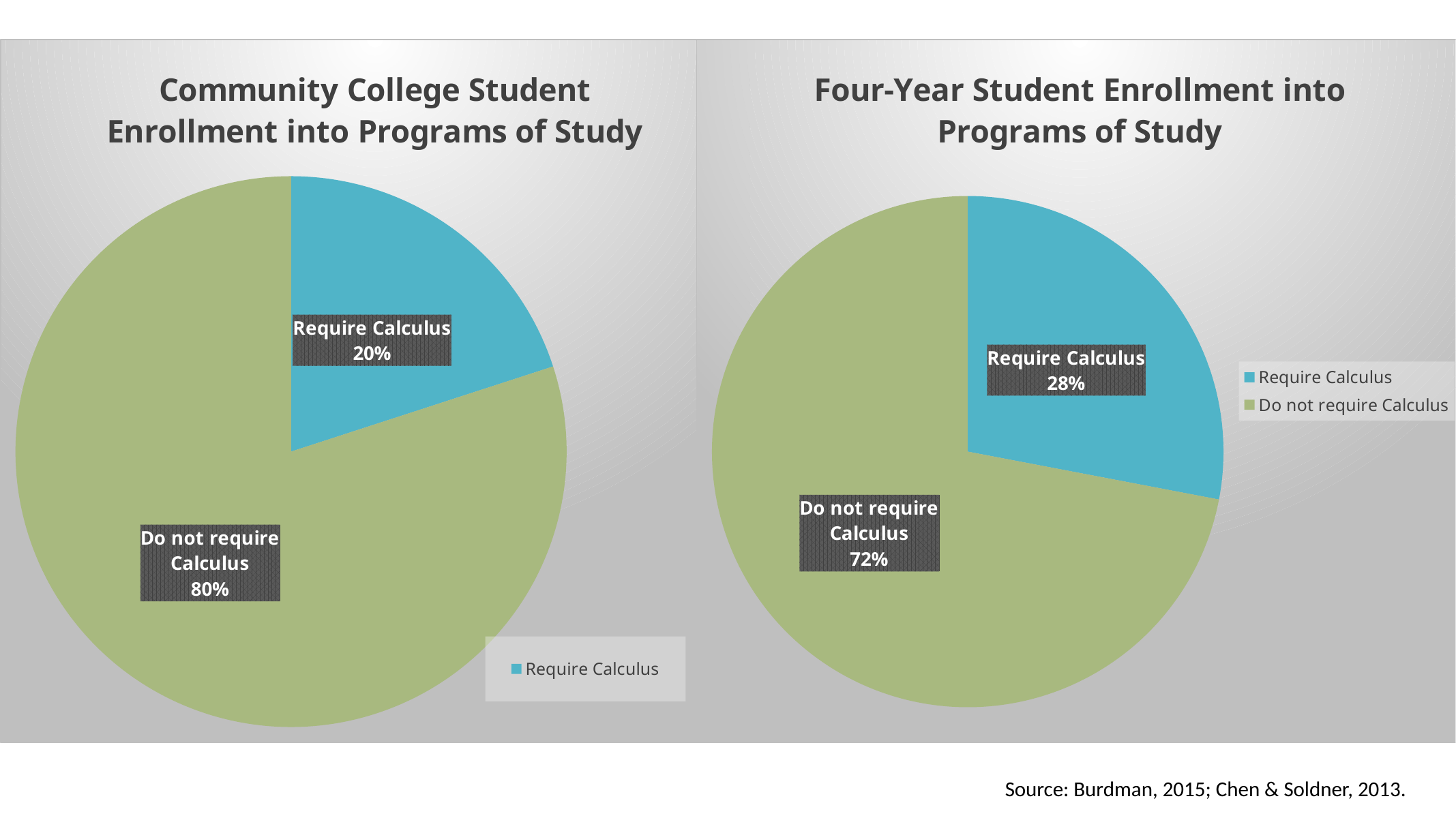
Which chart shows a larger 'Require Calculus' share, the Community College chart or the Four-Year chart? Four-Year Student Enrollment into Programs of Study In the 'Four-Year Student Enrollment into Programs of Study' chart, what share of students enroll in programs that do not require calculus? 72% In the 'Community College Student Enrollment into Programs of Study' chart, what share of students enroll in programs that do not require calculus? 80% In the 'Four-Year Student Enrollment into Programs of Study' chart, which slice is the largest? Do not require Calculus In the 'Four-Year Student Enrollment into Programs of Study' chart, what share of students enroll in programs that require calculus? 28% How many entries does the legend of the 'Four-Year Student Enrollment into Programs of Study' chart list? 2 In the 'Community College Student Enrollment into Programs of Study' chart, which slice is the smallest? Require Calculus In the 'Community College Student Enrollment into Programs of Study' chart, what share of students enroll in programs that require calculus? 20% In the 'Four-Year Student Enrollment into Programs of Study' chart, what is the difference between the 'Do not require Calculus' and 'Require Calculus' shares? 44 percentage points What kind of chart is the 'Community College Student Enrollment into Programs of Study' chart? Pie chart How many slices does the 'Four-Year Student Enrollment into Programs of Study' pie chart have? 2 In the 'Community College Student Enrollment into Programs of Study' chart, what is the difference between the 'Do not require Calculus' and 'Require Calculus' shares? 60 percentage points